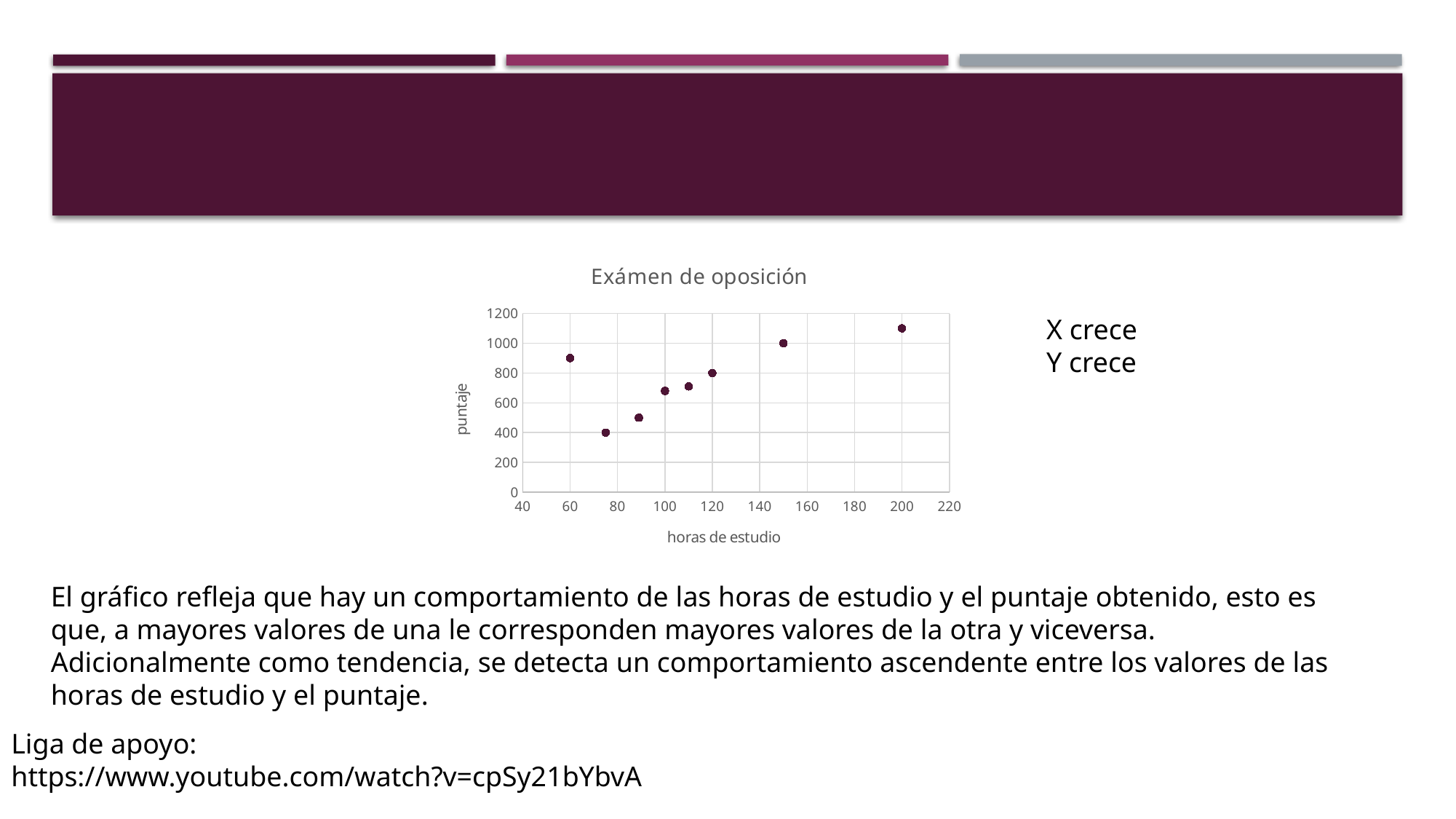
Is the puntaje for the point at 200 horas de estudio greater or less than 1000? greater How many data points are plotted in the chart? 8 What is the label of the x axis of the chart? horas de estudio What is the puntaje for the point at 150 horas de estudio? 1000 Do the puntaje values generally rise or fall as horas de estudio increase? rise Is the puntaje for the point at 100 horas de estudio greater or less than 600? greater Which point has the higher puntaje, the one at 120 horas de estudio or the one at 150 horas de estudio? 150 horas de estudio At how many horas de estudio is the point with the highest puntaje? 200 What type of chart is shown on the slide? scatter chart Is the puntaje for the point at 60 horas de estudio greater or less than 800? greater What is the title of the chart? Exámen de oposición What is the puntaje for the point at 120 horas de estudio? 800